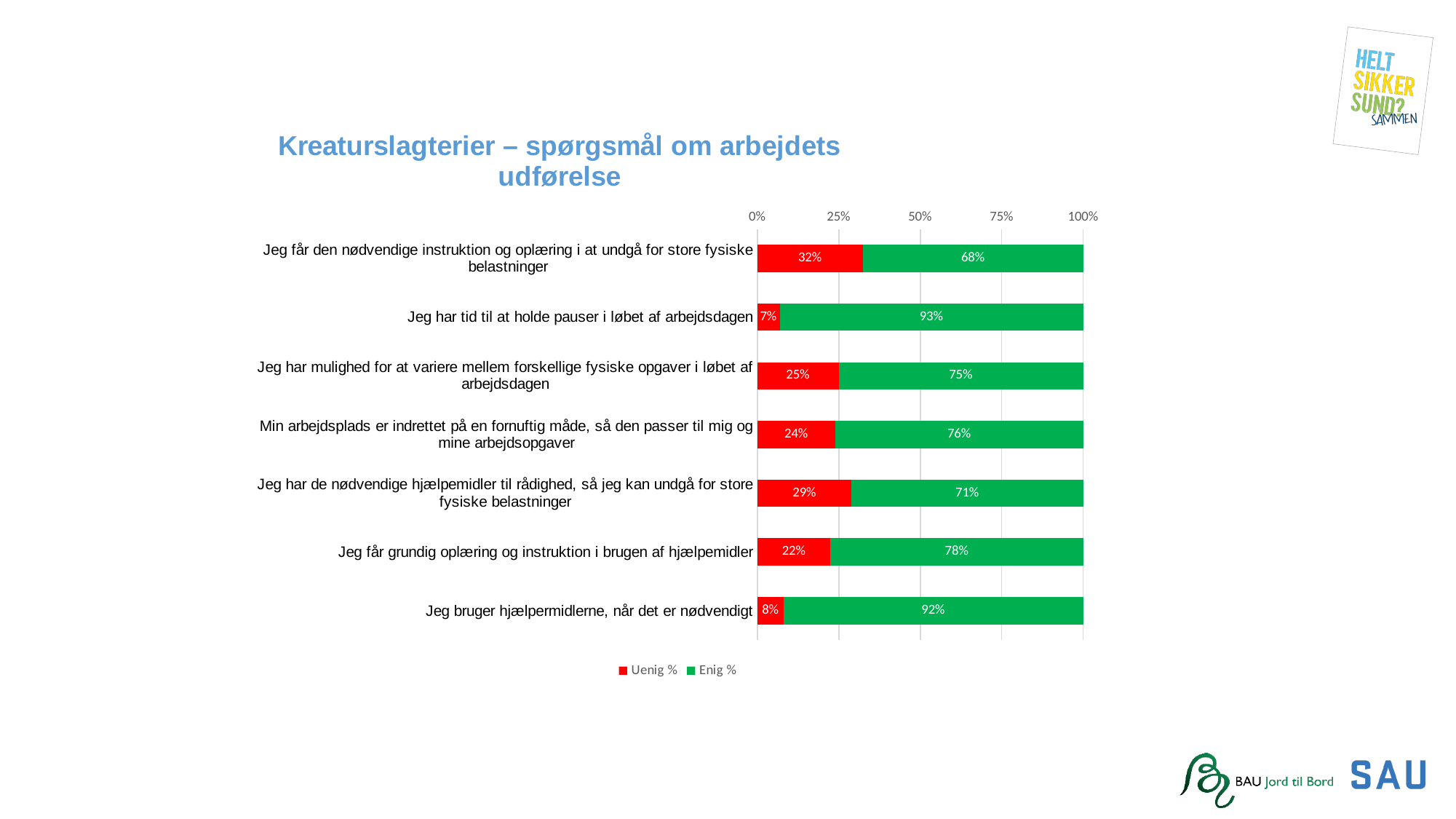
How many series does the legend list? 2 Which statement has the lowest Uenig % value? Jeg har tid til at holde pauser i løbet af arbejdsdagen What is the Enig % value for "Jeg har tid til at holde pauser i løbet af arbejdsdagen"? 93% Which statement has the highest Uenig % value? Jeg får den nødvendige instruktion og oplæring i at undgå for store fysiske belastninger How many statements are shown in the chart? 7 What is the Uenig % value for "Jeg får den nødvendige instruktion og oplæring i at undgå for store fysiske belastninger"? 32% Which colour represents Enig % in the chart? Green Which is larger: the Uenig % for "Jeg har mulighed for at variere mellem forskellige fysiske opgaver i løbet af arbejdsdagen" or the Uenig % for "Jeg får grundig oplæring og instruktion i brugen af hjælpemidler"? Jeg har mulighed for at variere mellem forskellige fysiske opgaver i løbet af arbejdsdagen What is the total of the stacked bar for "Min arbejdsplads er indrettet på en fornuftig måde, så den passer til mig og mine arbejdsopgaver"? 100% What is the difference between the Enig % values for "Jeg bruger hjælpermidlerne, når det er nødvendigt" and "Jeg har de nødvendige hjælpemidler til rådighed, så jeg kan undgå for store fysiske belastninger"? 21% What is the Enig % value for "Jeg får grundig oplæring og instruktion i brugen af hjælpemidler"? 78% What kind of chart is shown on the slide? Stacked bar chart